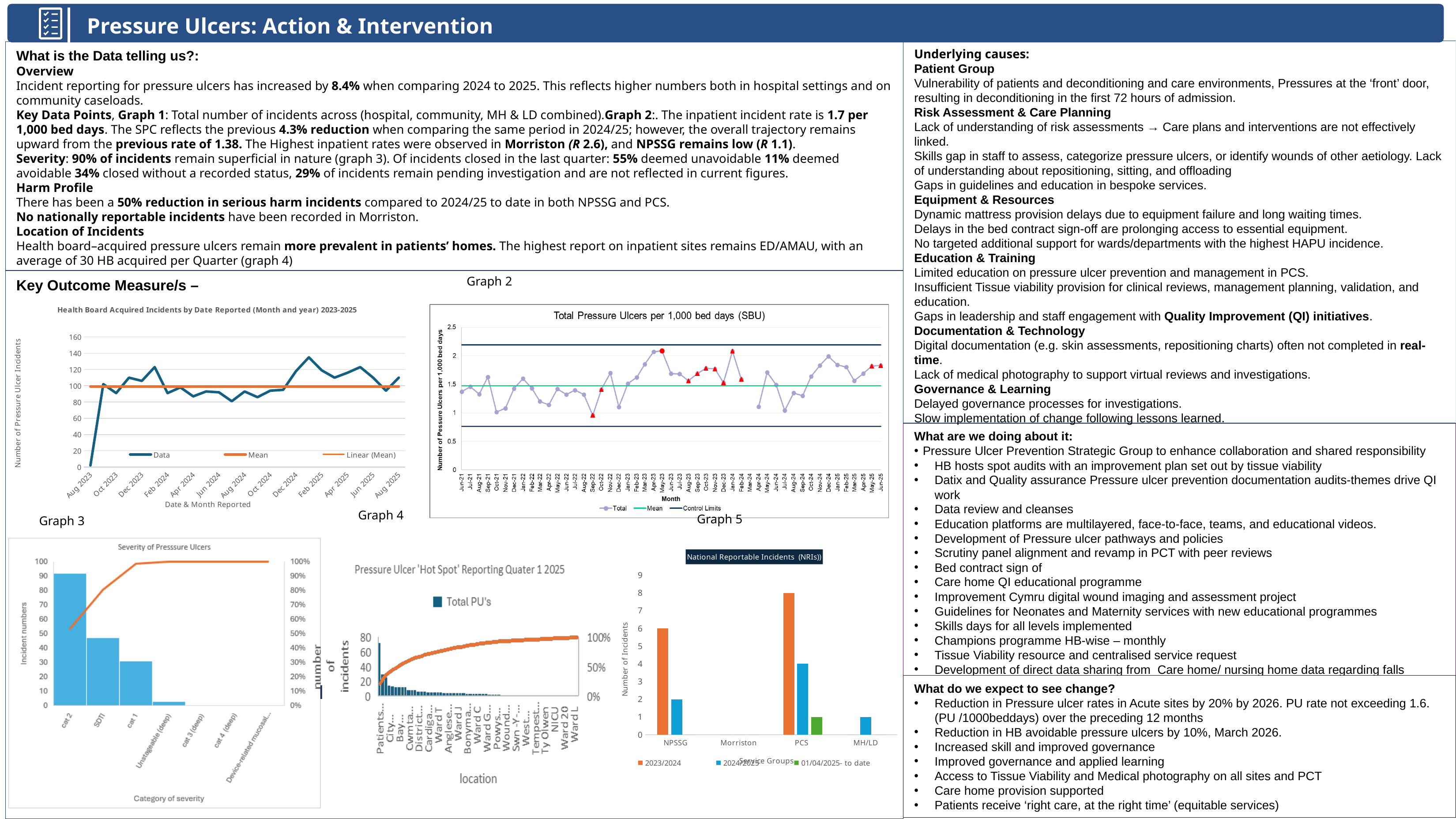
How many series does the legend of Graph 5, 'National Reportable Incidents (NRIs)', list? 3 In Graph 2, 'Total Pressure Ulcers per 1,000 bed days (SBU)', is the value for May-23 greater or less than 2? greater In Graph 3, 'Severity of Pressure Ulcers', is the value for cat 2 greater or less than 80? greater What kind of chart is Graph 5, 'National Reportable Incidents (NRIs)'? bar chart How many service groups are shown on the x axis of Graph 5, 'National Reportable Incidents (NRIs)'? 4 In Graph 3, 'Severity of Pressure Ulcers', which category of severity has the highest number of incidents? cat 2 In Graph 5, 'National Reportable Incidents (NRIs)', which service group has the highest number of incidents for 2023/2024? PCS In Graph 5, 'National Reportable Incidents (NRIs)', what is the difference between the PCS values for 2023/2024 and 2024/2025? 4 In Graph 5, 'National Reportable Incidents (NRIs)', what is the number of incidents for MH/LD in 2024/2025? 1 In Graph 5, 'National Reportable Incidents (NRIs)', what is the number of incidents for PCS in 2023/2024? 8 In Graph 5, 'National Reportable Incidents (NRIs)', which is larger for NPSSG: the 2023/2024 value or the 2024/2025 value? 2023/2024 How many series does the legend of Graph 1, 'Health Board Acquired Incidents by Date Reported (Month and year) 2023-2025', list? 3